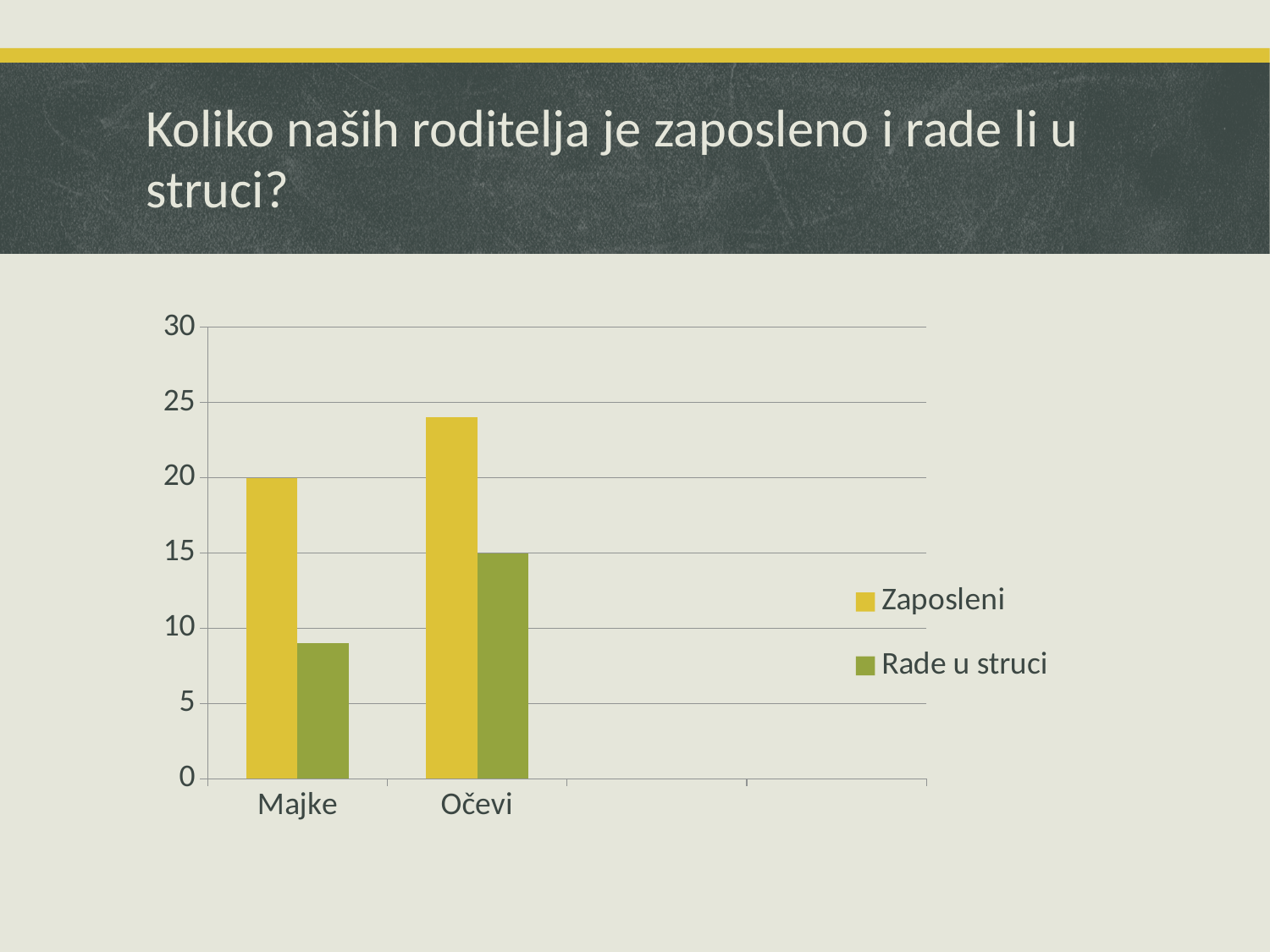
Is the Zaposleni value for Očevi greater or less than 20? greater How many series does the legend list? 2 What are the two series names listed in the legend? Zaposleni and Rade u struci What is the Rade u struci value for Očevi? 15 Which category has the higher Zaposleni value, Majke or Očevi? Očevi How many categories are shown on the x axis? 2 Which category has the lowest Rade u struci value? Majke Is the Rade u struci value for Majke greater or less than 10? less What type of chart is shown on the slide? bar chart What is the Zaposleni value for Majke? 20 What is the difference between the Zaposleni value for Majke and the Rade u struci value for Očevi? 5 Is the Zaposleni value for Očevi greater or less than 25? less